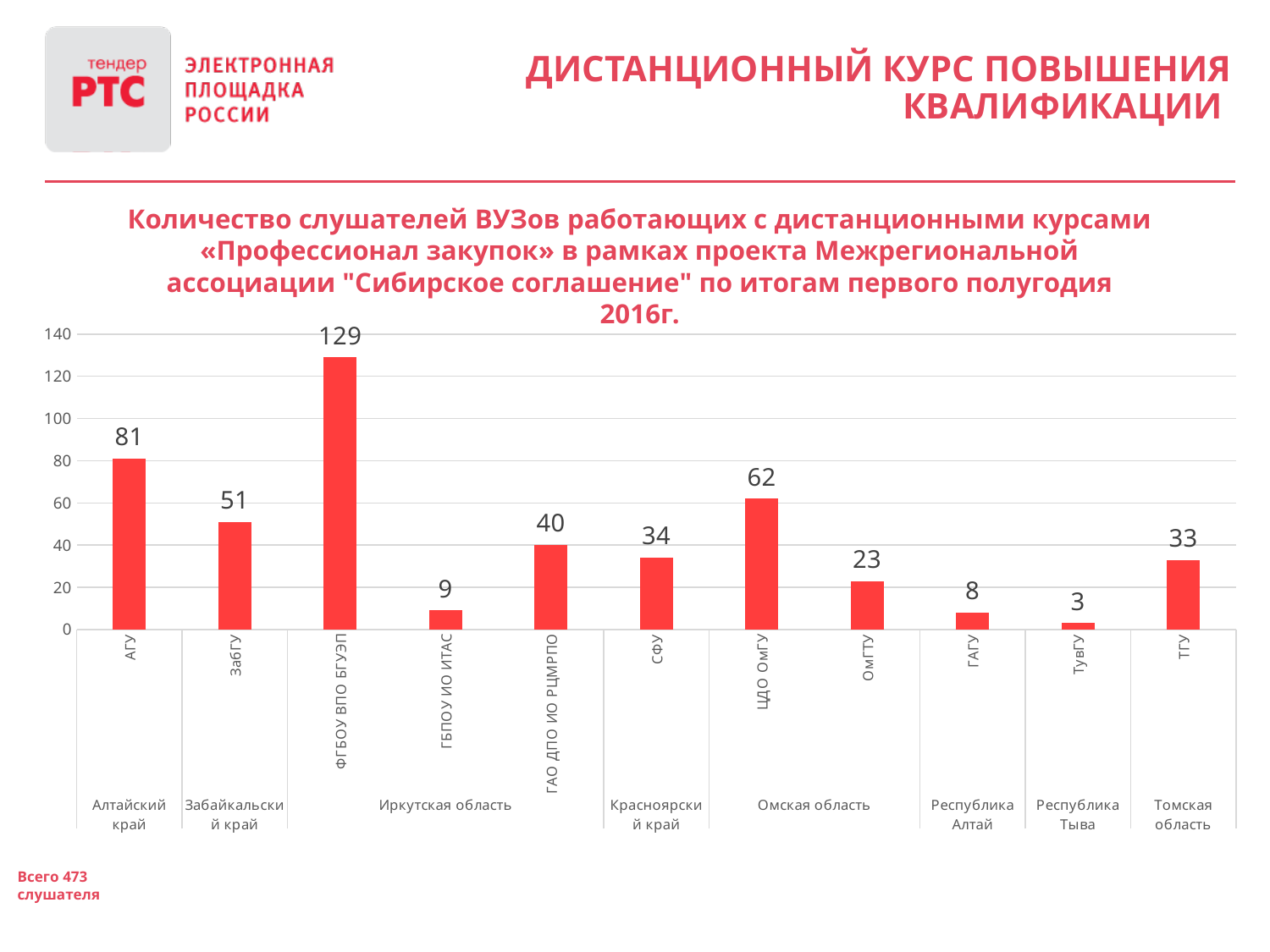
What is the value for ЦДО ОмГУ? 62 What is the difference between the values for ЗабГУ and ОмГТУ? 28 Which is larger, the value for СФУ or the value for ГАО ДПО ИО РЦМРПО? ГАО ДПО ИО РЦМРПО Which institution has the highest value? ФГБОУ ВПО БГУЭП What is the value for ТГУ? 33 Which institution has the lowest value? ТувГУ How many bars are shown in the chart? 11 What is the value for АГУ? 81 Is the value for ЦДО ОмГУ greater or less than 40? greater What is the difference between the values for ФГБОУ ВПО БГУЭП and АГУ? 48 What kind of chart is shown on the slide? bar chart What total number of listeners is stated at the bottom left of the slide? 473